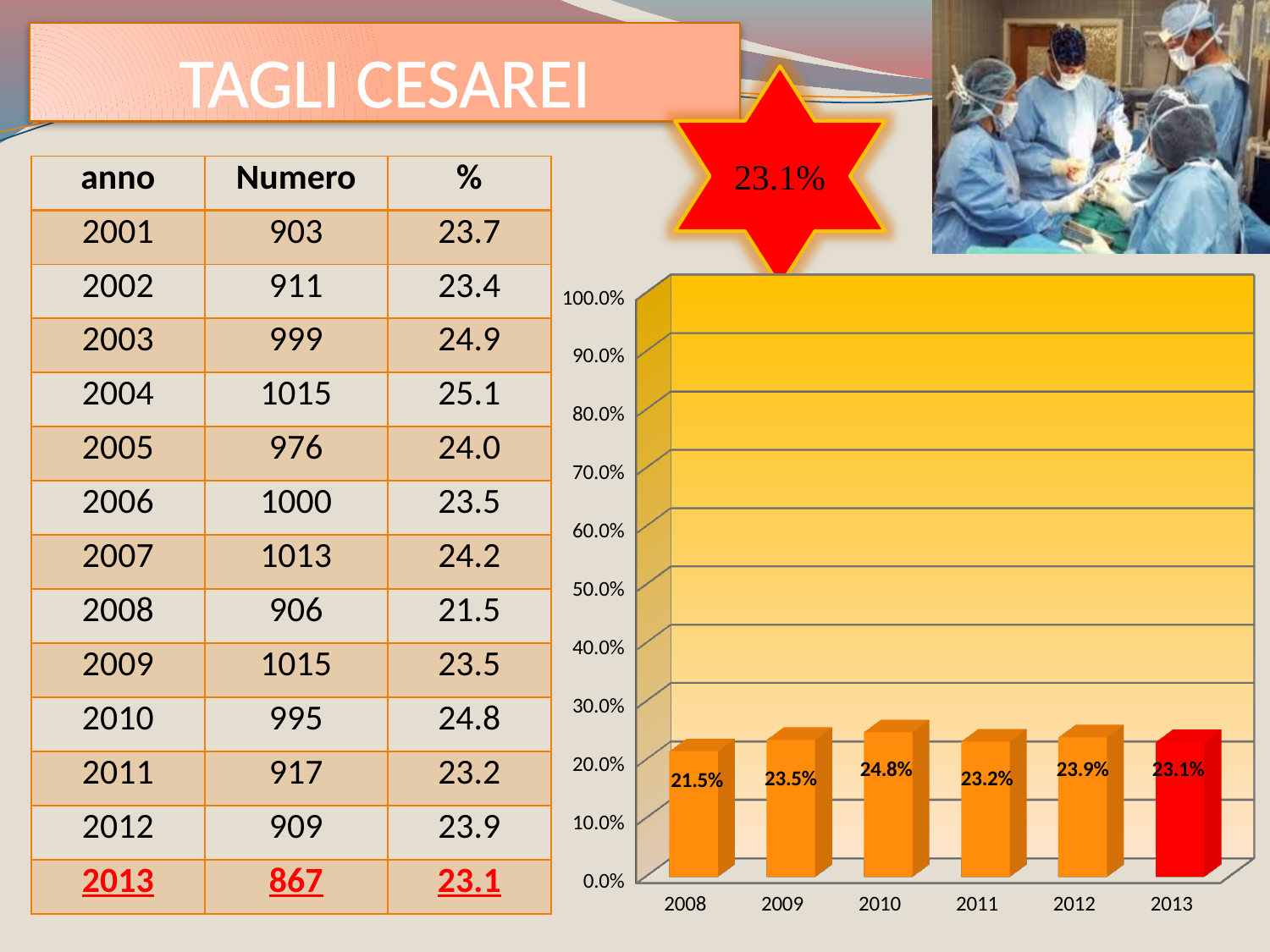
What is the difference between the values for 2010 and 2008 in the bar chart? 3.3% Is the value for 2012 in the bar chart greater or less than 30.0%? less What is the value for 2013 in the bar chart? 23.1% What is the value for 2012 in the bar chart? 23.9% Which is larger in the bar chart, the value for 2009 or the value for 2011? 2009 What kind of chart is shown on the slide? bar chart What is the value for 2010 in the bar chart? 24.8% What is the value for 2008 in the bar chart? 21.5% Which year has the highest value in the bar chart? 2010 Which year has the lowest value in the bar chart? 2008 How many years are shown on the x axis of the bar chart? 6 Which bar in the chart is coloured red rather than orange? 2013